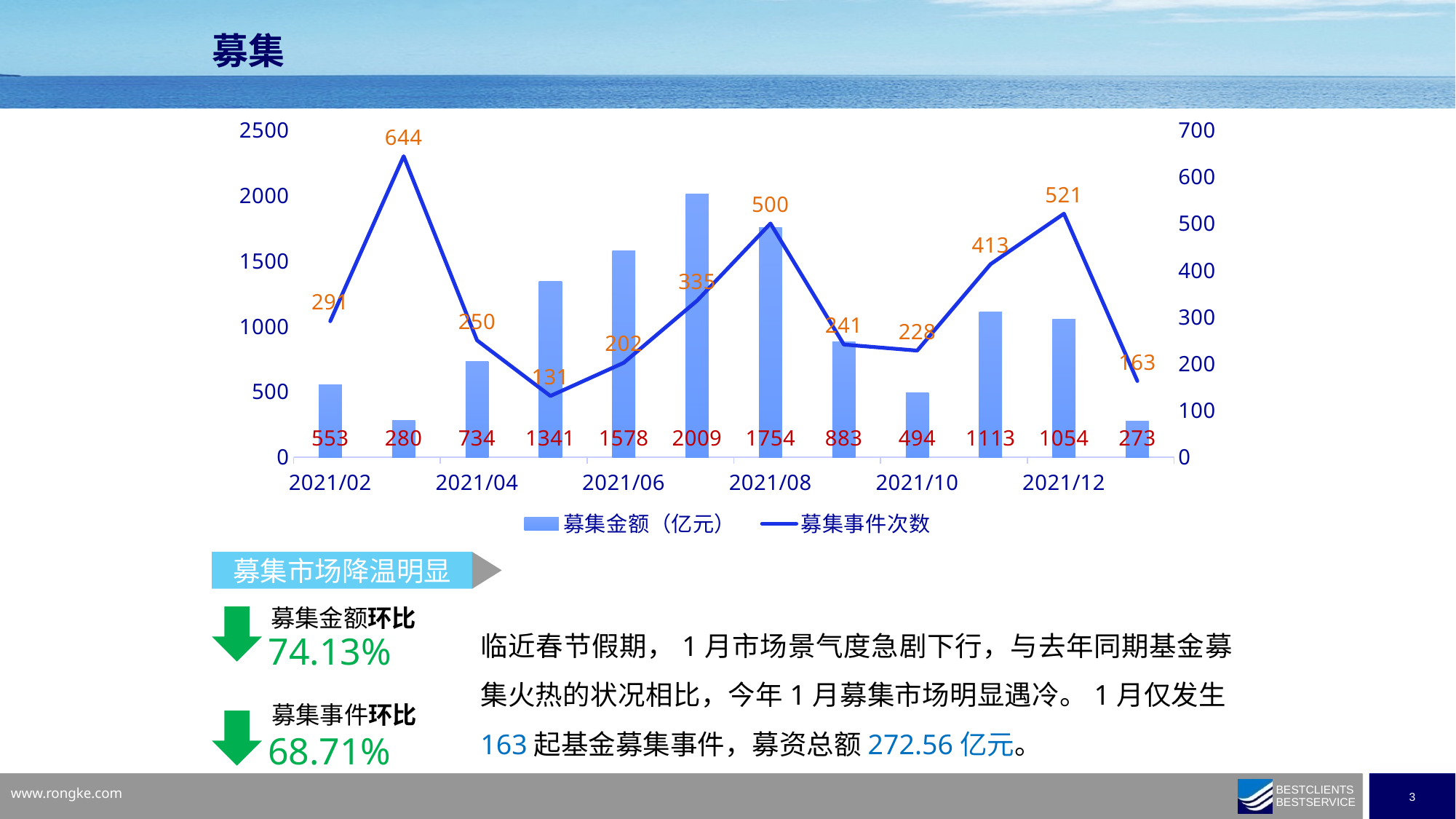
Which has the larger 募集事件次数, 2021/04 or 2021/12? 2021/12 Which series is drawn as a line in the chart? 募集事件次数 What is the highest 募集事件次数 value shown in the chart? 644 What kind of chart is shown on the slide? A combined bar and line chart How many bars are plotted in the chart? 12 What is the highest 募集金额（亿元） value shown in the chart? 2009 What is the difference in 募集金额（亿元） between 2021/08 and 2021/10? 1260 What is the 募集金额（亿元） value for 2021/02? 553 What is the 募集金额（亿元） value for 2021/12? 1054 What is the lowest 募集事件次数 value shown in the chart? 131 How many series does the legend list? 2 What is the 募集事件次数 value for 2021/08? 500